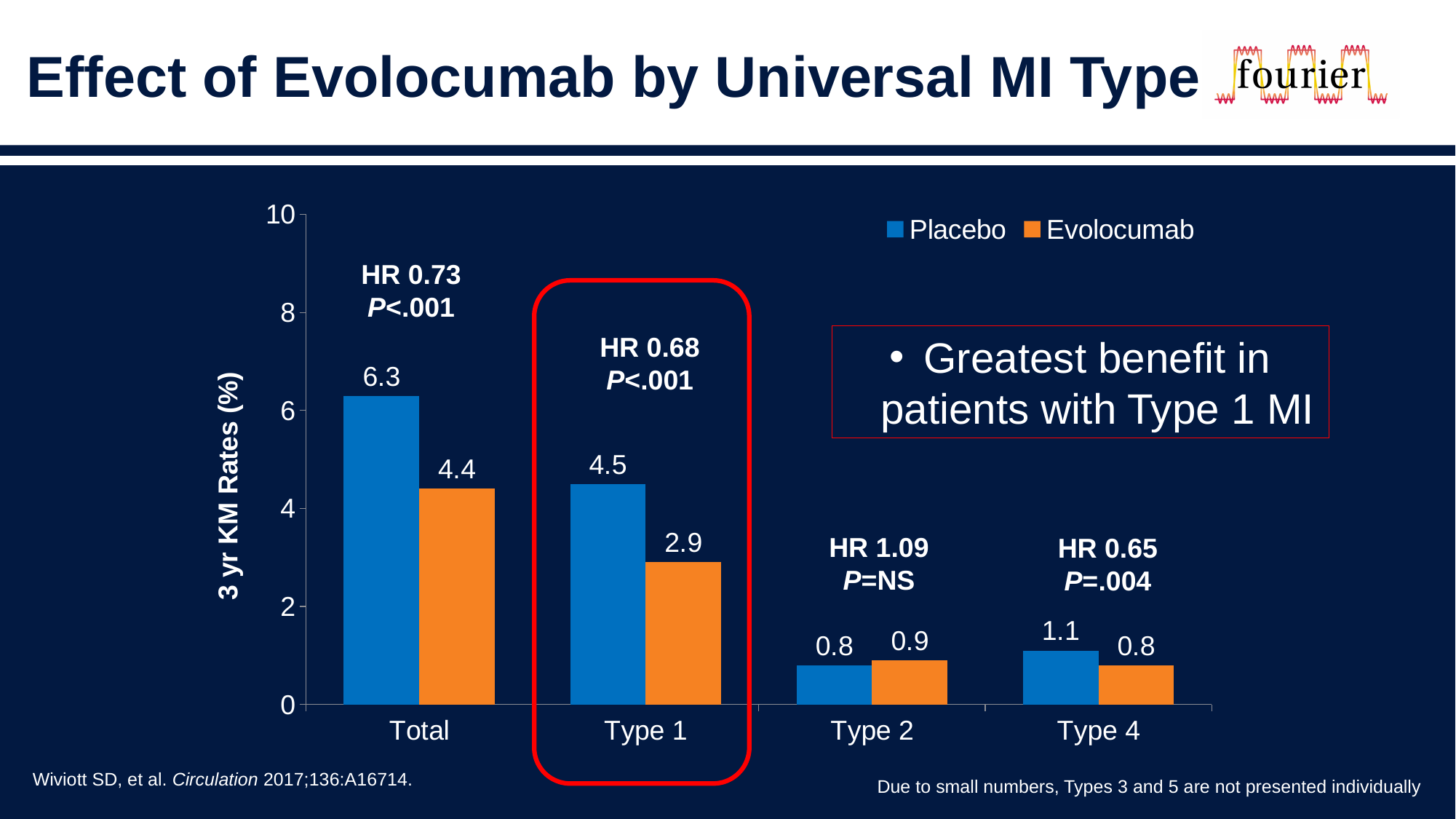
What is the 3 yr KM rate for Placebo in the Total group? 6.3 What is the 3 yr KM rate for Evolocumab in the Type 1 group? 2.9 What is the 3 yr KM rate for Placebo in the Type 4 group? 1.1 What is the difference between the Placebo and Evolocumab rates in the Type 1 group? 1.6 What kind of chart is shown on the slide? Bar chart Which category has the lowest Placebo rate? Type 2 What is the 3 yr KM rate for Evolocumab in the Type 2 group? 0.9 How many series does the legend list? 2 Which MI type category has the highest Placebo rate? Total How many categories are shown on the x axis? 4 In the Type 2 group, which is larger, the Placebo rate or the Evolocumab rate? Evolocumab What is the difference between the Placebo and Evolocumab rates in the Total group? 1.9